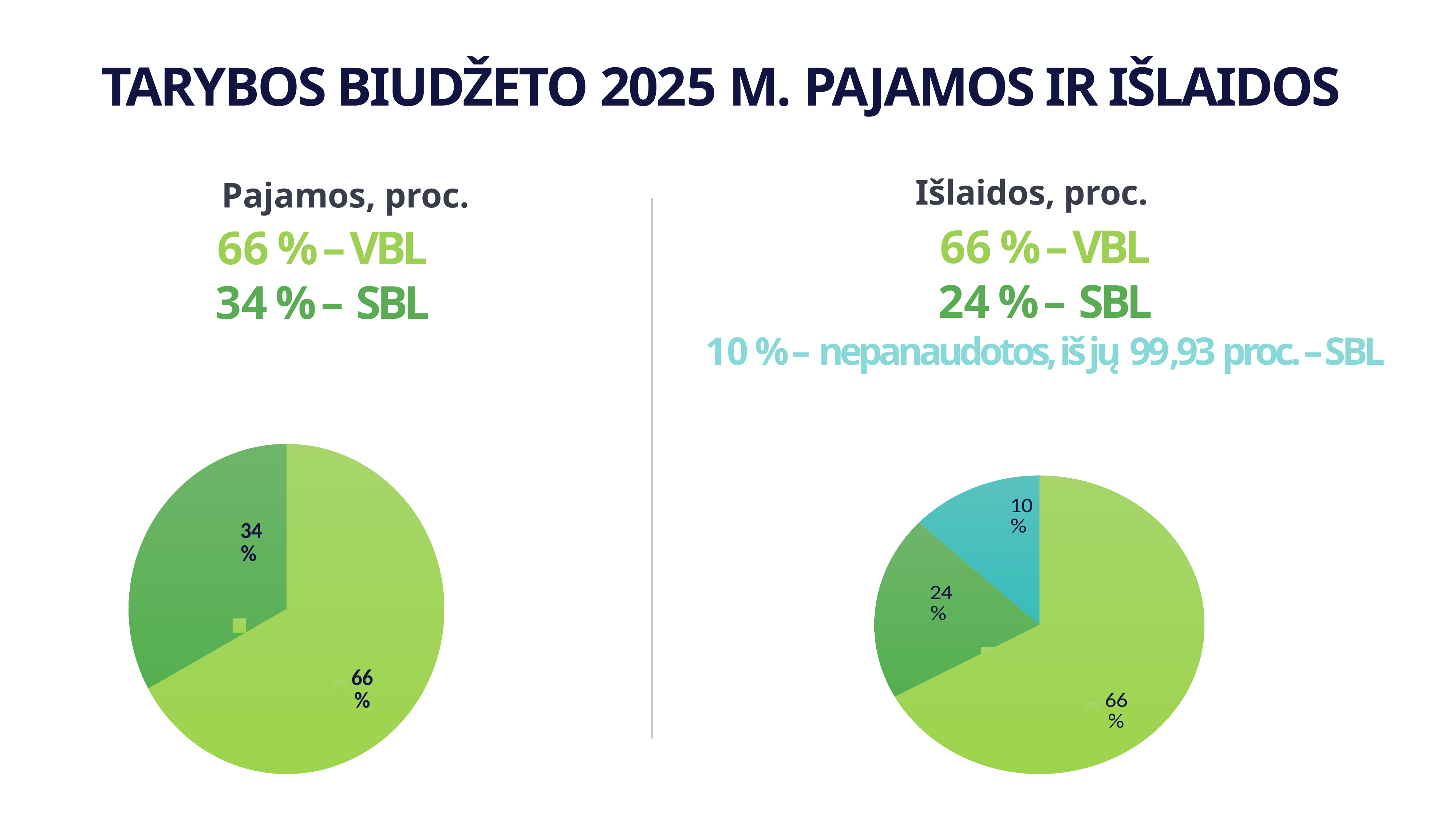
How many slices does the "Pajamos, proc." pie chart have? 2 In the "Pajamos, proc." pie chart, what is the difference between the VBL and SBL shares? 32 % In the "Pajamos, proc." pie chart, which slice is the largest? VBL (66 %) What kind of chart is shown under "Pajamos, proc." on the left of the slide? Pie chart How many slices does the "Išlaidos, proc." pie chart have? 3 In the "Pajamos, proc." pie chart, what share is labelled for SBL? 34 % In the "Išlaidos, proc." pie chart, which is larger: the SBL slice or the nepanaudotos slice? SBL In the "Išlaidos, proc." pie chart, which slice is the smallest? Nepanaudotos (10 %) In the "Išlaidos, proc." pie chart, what share is labelled as nepanaudotos (unused)? 10 % What is the title of the slide containing the two pie charts? TARYBOS BIUDŽETO 2025 M. PAJAMOS IR IŠLAIDOS In the "Išlaidos, proc." pie chart, what share is labelled for SBL? 24 % In the "Pajamos, proc." pie chart, what share is labelled for VBL? 66 %